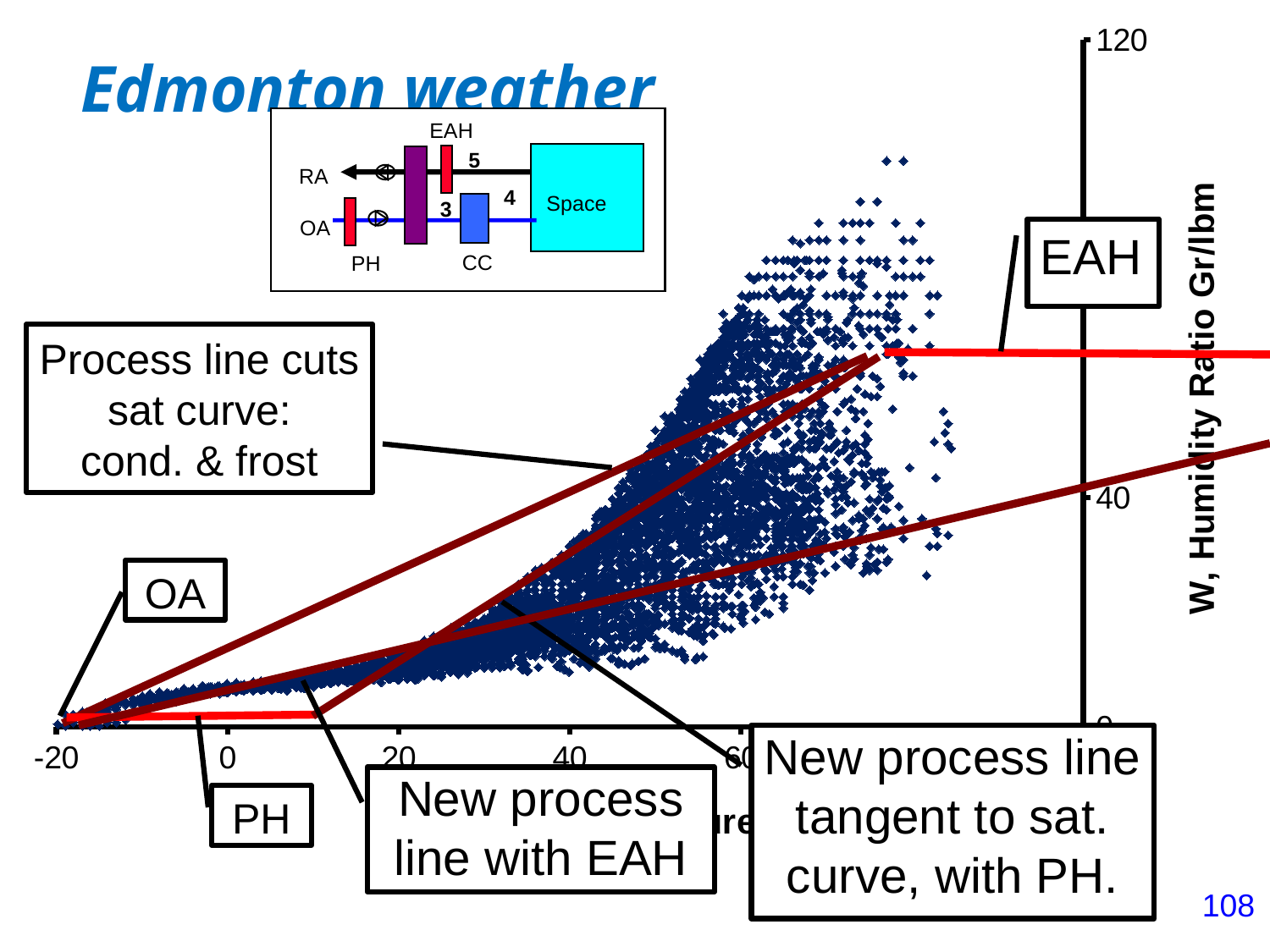
As the horizontal-axis value increases, does the upper edge of the scattered data points generally rise or fall? rise Is the humidity ratio of the highest scattered data point greater or less than 40? greater What is the highest value shown on the vertical axis of the chart? 120 What is the label of the vertical axis of the chart? W, Humidity Ratio Gr/lbm Which labelled point on the chart lies at the far left end of the data, near -20 on the horizontal axis? OA What kind of chart is shown on the slide? scatter chart What is the title of the chart on the slide? Edmonton weather What is the lowest value shown on the horizontal axis of the chart? -20 Is the humidity ratio of the data points near the -20 end of the horizontal axis greater or less than 40? less